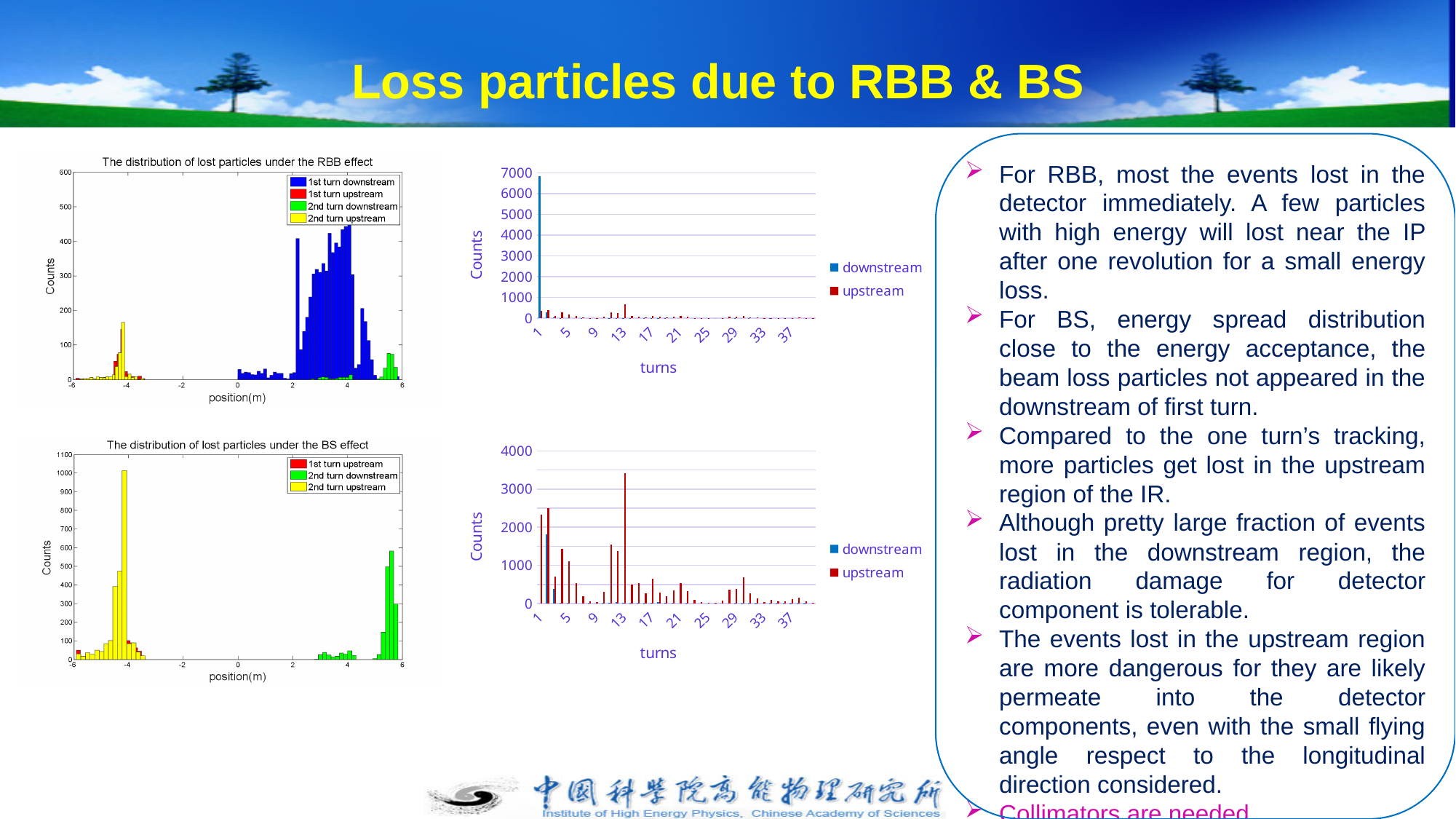
What kind of chart is the lower middle chart of counts versus turns? bar chart In the lower middle chart of counts versus turns, at which turn does the upstream series reach its highest value? 13 In the upper middle chart of counts versus turns, what are the two legend entries? downstream, upstream In the chart titled 'The distribution of lost particles under the BS effect', is the peak of the 2nd turn upstream (yellow) bars near position -4 m greater or less than 900 counts? greater In the lower middle chart of counts versus turns, is the upstream value at turn 13 greater or less than 3000? greater In the chart titled 'The distribution of lost particles under the RBB effect', how many entries does the legend list? 4 In the upper middle chart of counts versus turns, which series has the tallest bar? downstream In the upper middle chart of counts versus turns, is the downstream value at turn 1 greater or less than 6000? greater In the chart titled 'The distribution of lost particles under the BS effect', how many entries does the legend list? 3 In the upper middle chart of counts versus turns, how many series does the legend list? 2 In the lower middle chart of counts versus turns, what is the highest value shown on the y axis? 4000 In the chart titled 'The distribution of lost particles under the RBB effect', which legend entry corresponds to the blue bars? 1st turn downstream